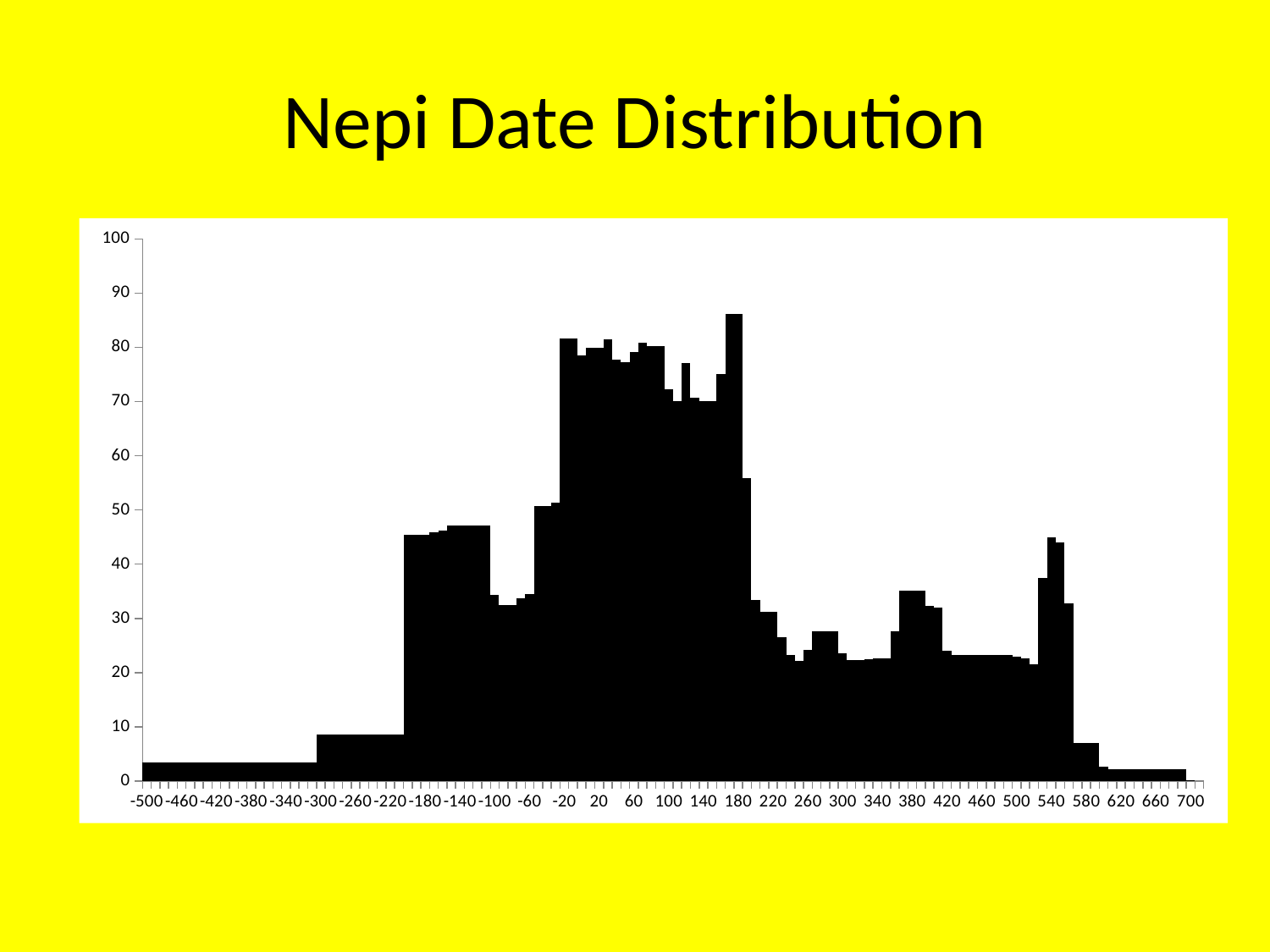
What is the title of the chart? Nepi Date Distribution Is the value at 300 greater or less than 30? less Which has the larger value, 180 or 540? 180 What kind of chart is shown on the slide? bar chart Is the value at 700 greater or less than 10? less What is the highest value shown on the vertical axis? 100 Is the value at 180 greater or less than 80? greater Do the values rise or fall along the x axis from 580 to 700? fall